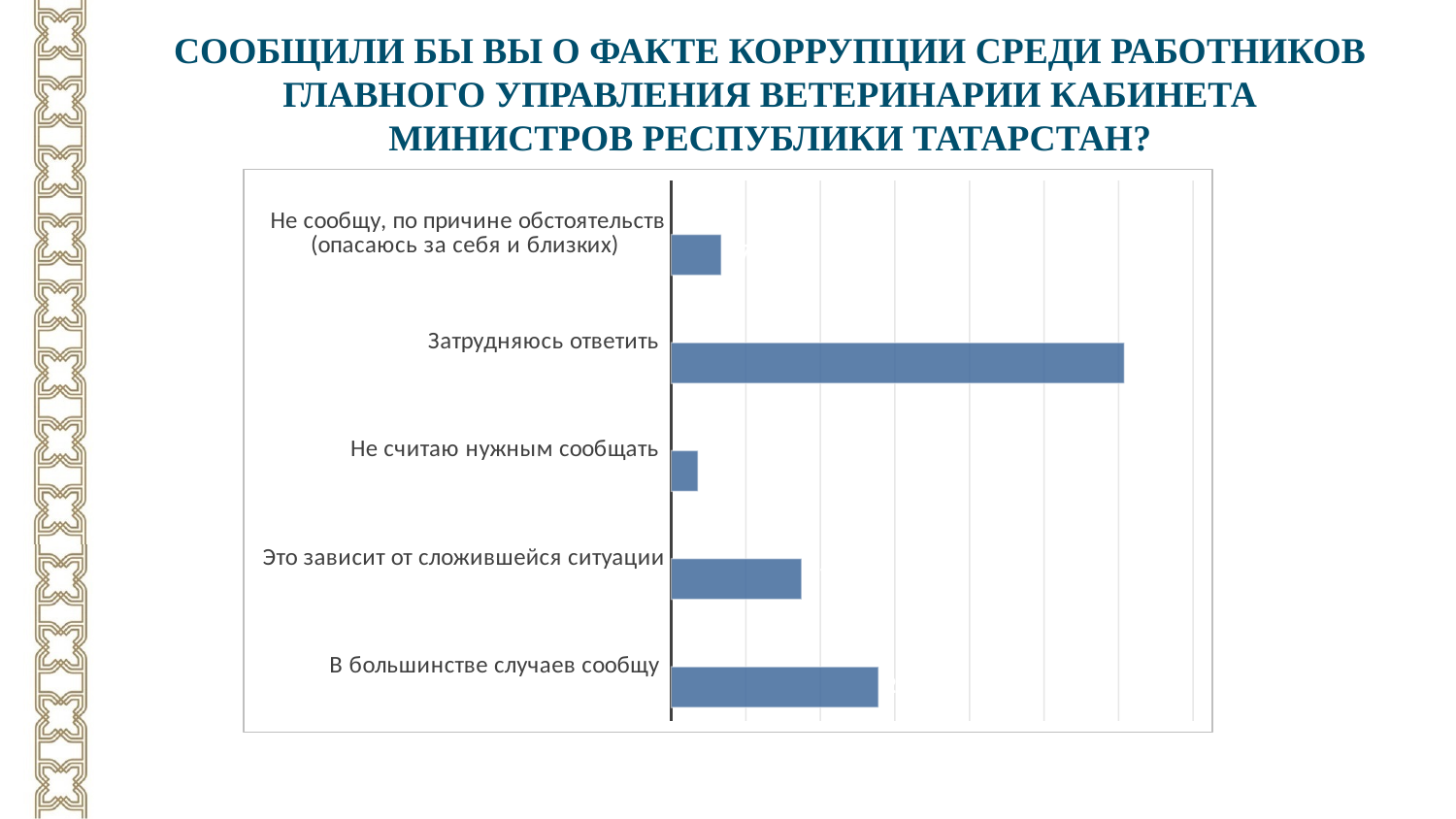
Which has the larger value: "Затрудняюсь ответить" or "В большинстве случаев сообщу"? Затрудняюсь ответить Which has the larger value: "Не сообщу, по причине обстоятельств (опасаюсь за себя и близких)" or "Не считаю нужным сообщать"? Не сообщу, по причине обстоятельств (опасаюсь за себя и близких) What kind of chart is shown on the slide? Bar chart Which answer option has the second-longest bar? В большинстве случаев сообщу What question is posed in the slide title above the chart? Сообщили бы вы о факте коррупции среди работников Главного управления ветеринарии Кабинета Министров Республики Татарстан? Which answer option has the longest bar? Затрудняюсь ответить How many categories (answer options) are shown in the chart? 5 Are the bars in the chart horizontal or vertical? Horizontal Which answer option has the shortest bar? Не считаю нужным сообщать Which has the larger value: "Это зависит от сложившейся ситуации" or "Не считаю нужным сообщать"? Это зависит от сложившейся ситуации